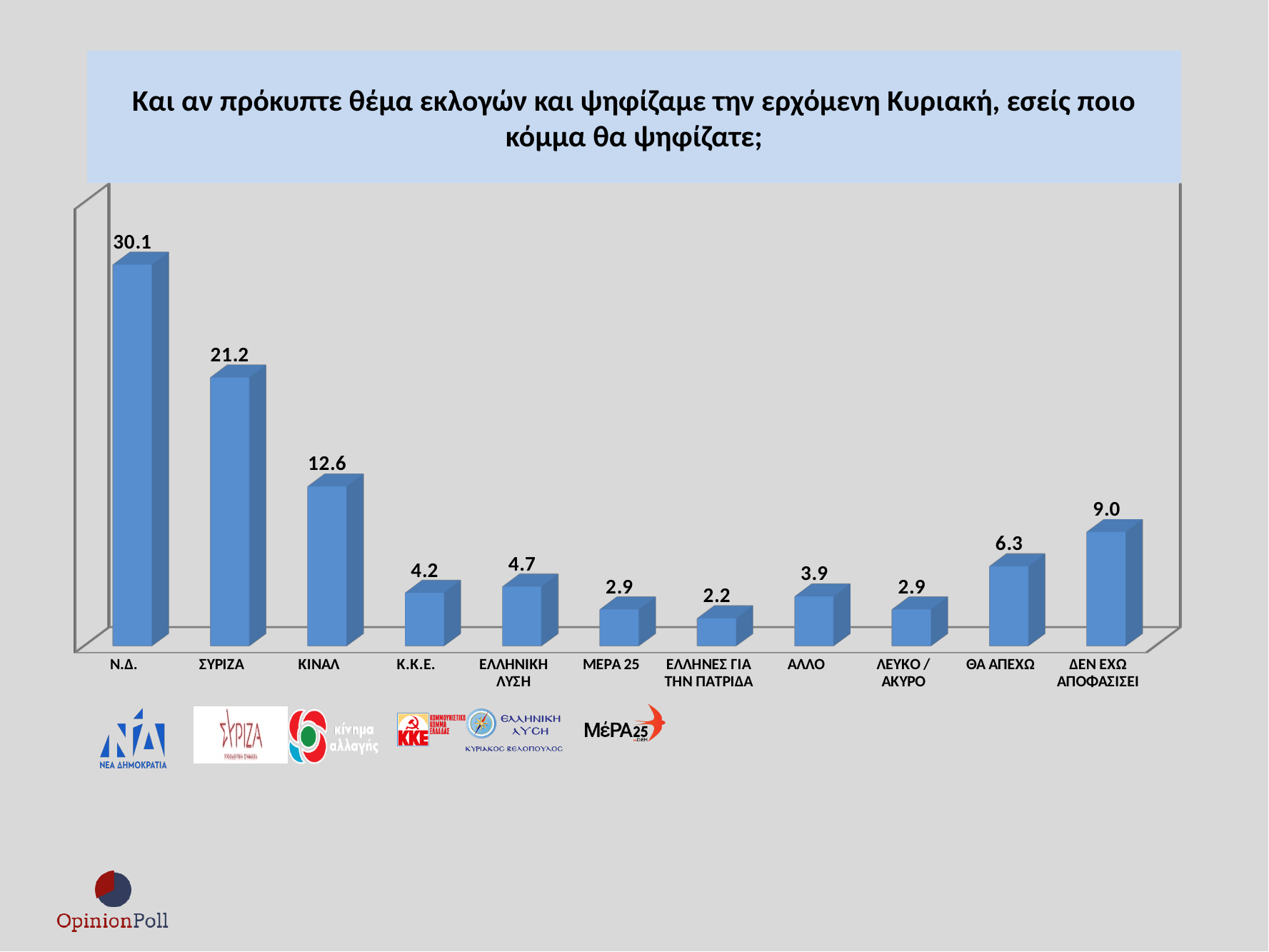
What is the difference between the values for Ν.Δ. and ΣΥΡΙΖΑ? 8.9 What is the value for ΚΙΝΑΛ? 12.6 What is the difference between the values for ΕΛΛΗΝΙΚΗ ΛΥΣΗ and Κ.Κ.Ε.? 0.5 What is the value for Ν.Δ.? 30.1 What is the value for ΣΥΡΙΖΑ? 21.2 What kind of chart is shown on the slide? bar chart Which is larger, the value for ΘΑ ΑΠΕΧΩ or the value for ΑΛΛΟ? ΘΑ ΑΠΕΧΩ How many categories are shown on the chart? 11 What is the value for ΜΕΡΑ 25? 2.9 Which category has the lowest value? ΕΛΛΗΝΕΣ ΓΙΑ ΤΗΝ ΠΑΤΡΙΔΑ Which category has the highest value? Ν.Δ. What is the value for ΔΕΝ ΕΧΩ ΑΠΟΦΑΣΙΣΕΙ? 9.0